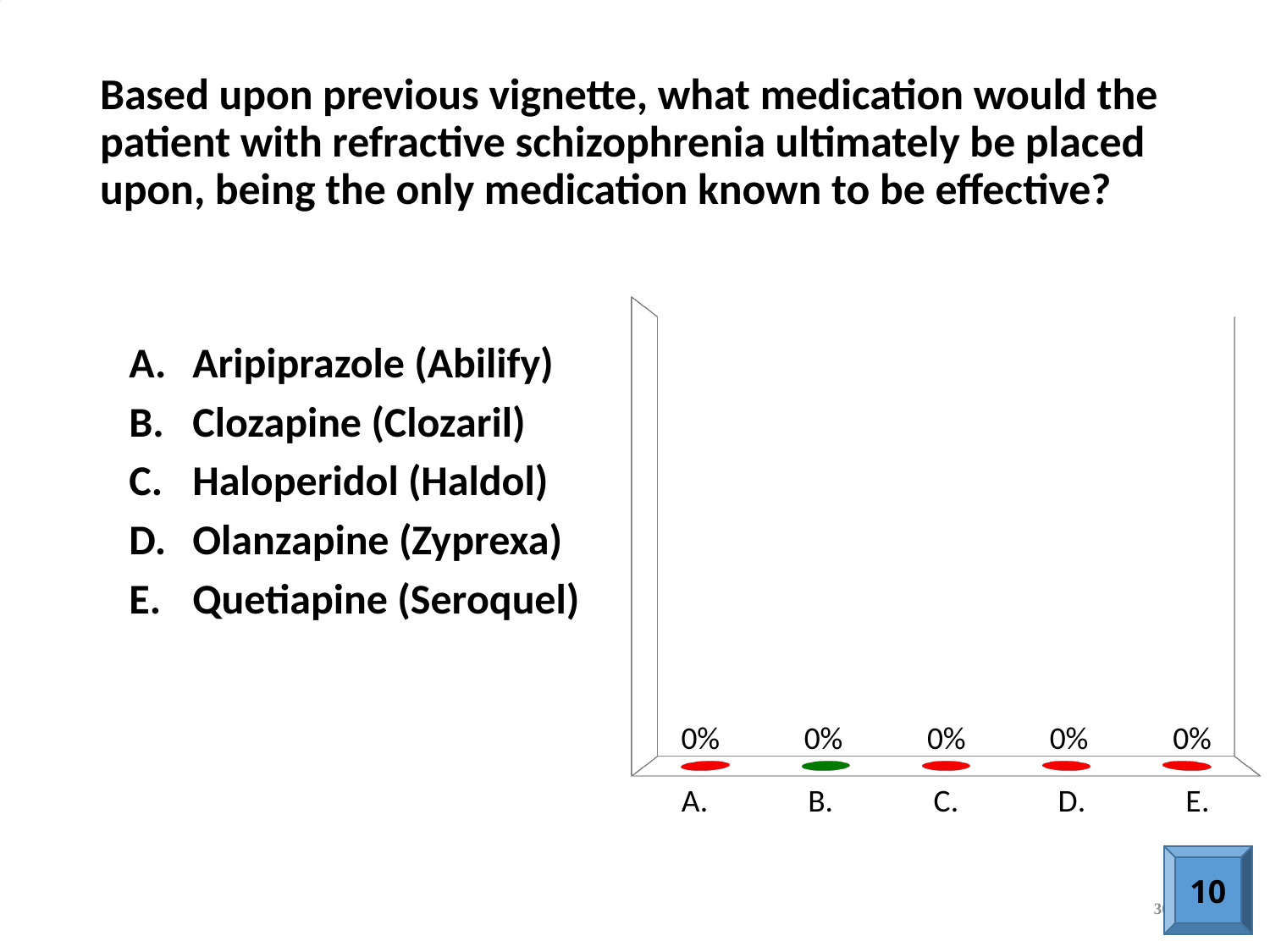
What are the category labels along the x axis of the chart? A., B., C., D., E. What is the difference between the values for A. and B. in the chart? 0% What is the total of the values for all five categories in the chart? 0% What is the value shown for category B. in the chart? 0% What is the value shown for category A. in the chart? 0% What kind of chart is shown on the slide? bar chart What is the value shown for category C. in the chart? 0% What is the value shown for category E. in the chart? 0% What is the value shown for category D. in the chart? 0% Which category's bar is coloured green in the chart? B. How many categories are plotted in the chart? 5